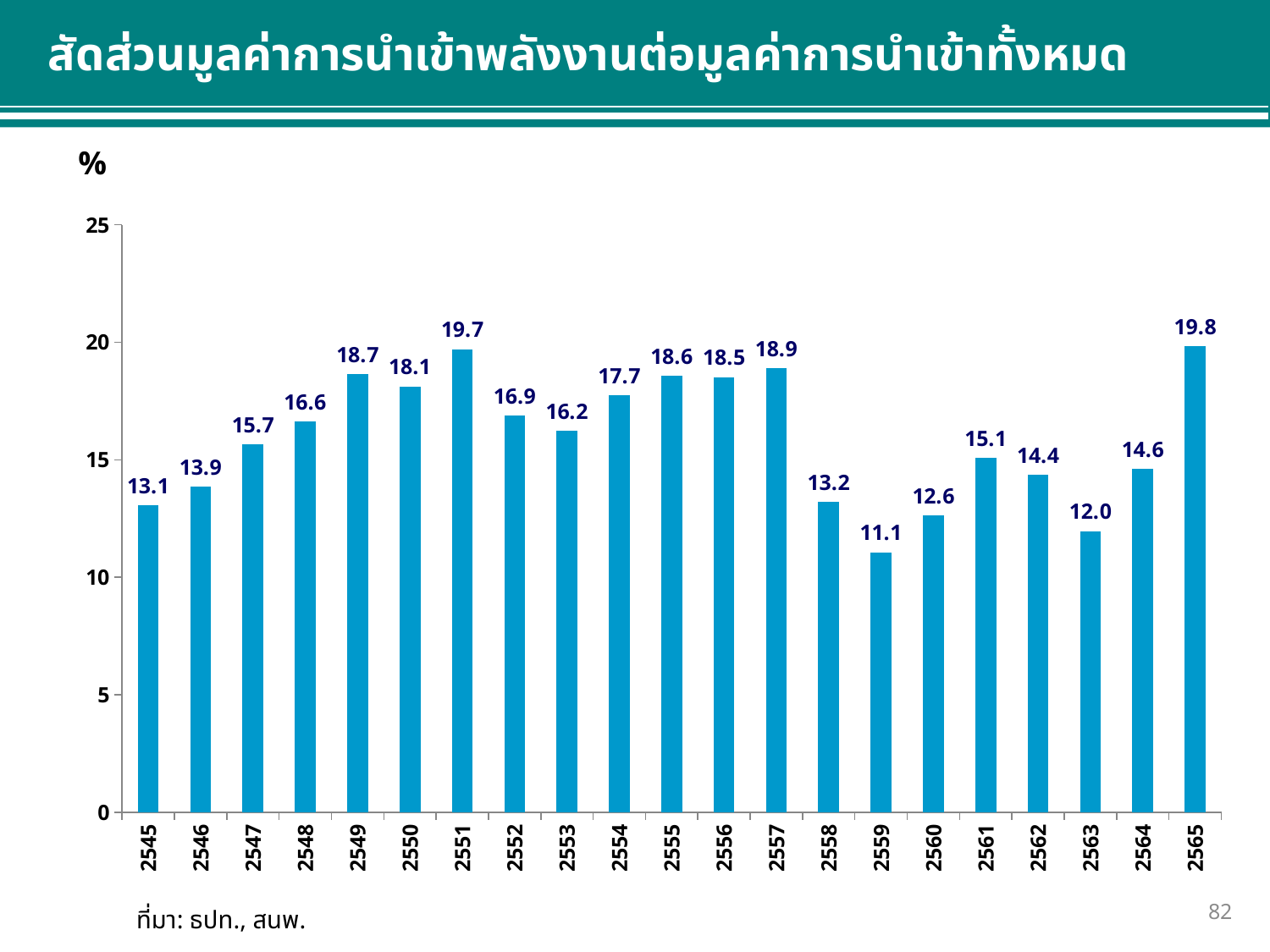
Which year has the lowest value? 2559 What is the value for 2559? 11.1 How many years are shown on the x axis? 21 What is the value for 2551? 19.7 What kind of chart is shown on the slide? bar chart What is the value for 2549? 18.7 What is the difference between the values for 2557 and 2558? 5.7 Which is larger, the value for 2561 or the value for 2562? 2561 Which year has the highest value? 2565 What is the value for 2565? 19.8 Do the values rise or fall from 2557 to 2559? fall Is the value for 2563 greater or less than 15? less